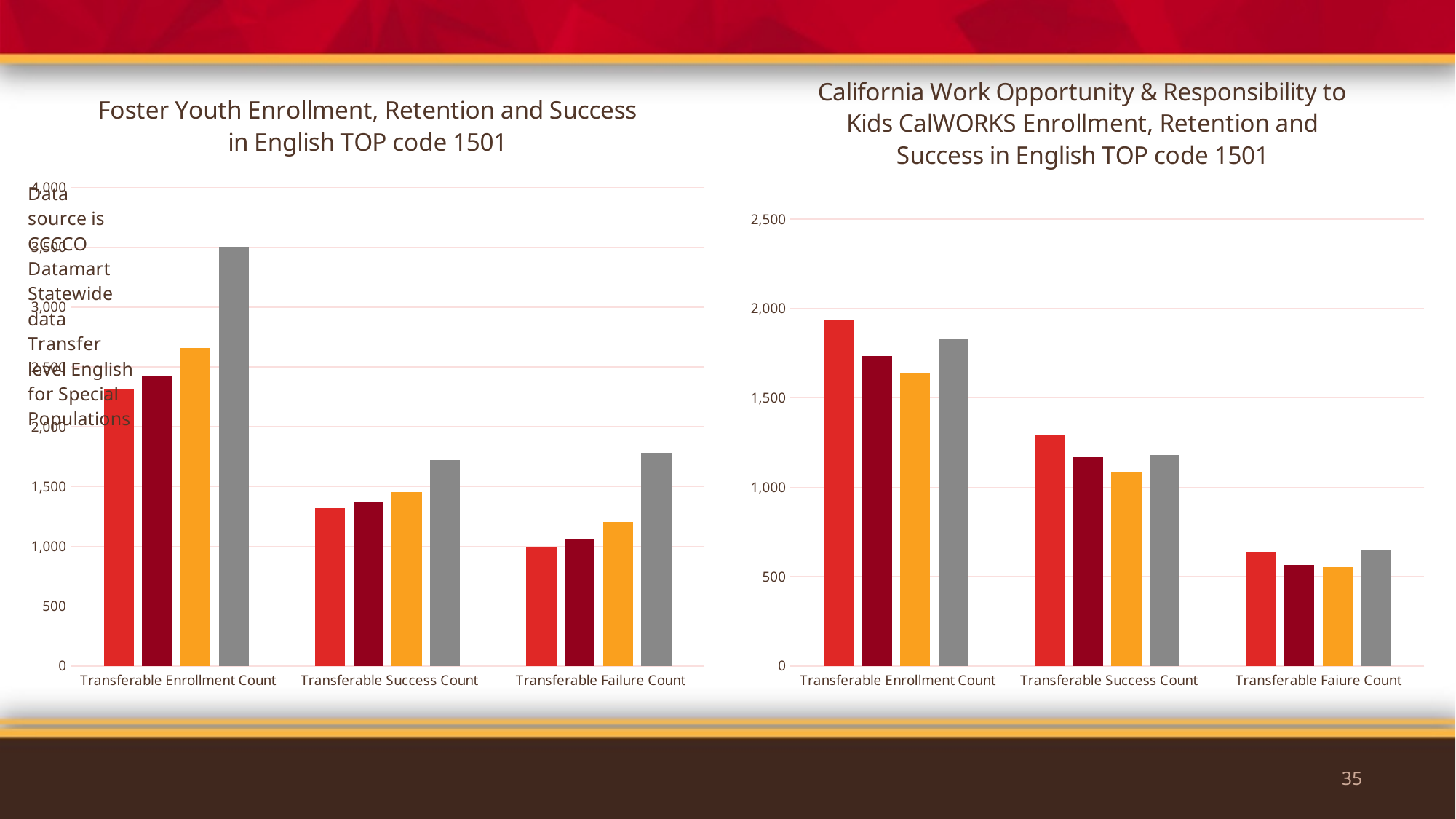
In the CalWORKS chart on the right, are all the bars for Transferable Faiure Count greater or less than 1,000? less What is the highest value shown on the y axis of the CalWORKS chart on the right? 2,500 In the Foster Youth chart on the left, are all the bars for Transferable Success Count greater or less than 2,000? less What is the title of the chart on the left of the slide? Foster Youth Enrollment, Retention and Success in English TOP code 1501 In the CalWORKS chart on the right, do the bar heights rise or fall moving from Transferable Enrollment Count to Transferable Faiure Count? fall How many bars are plotted for each category in the Foster Youth chart on the left? 4 In the CalWORKS chart on the right, is the tallest bar for Transferable Enrollment Count greater or less than 1,500? greater In the Foster Youth chart on the left, which category contains the tallest bar? Transferable Enrollment Count How many categories are shown on the x axis of the CalWORKS chart on the right? 3 In the CalWORKS chart on the right, which category has the shortest bars? Transferable Faiure Count What kind of chart is the Foster Youth Enrollment, Retention and Success chart on the left? Bar chart